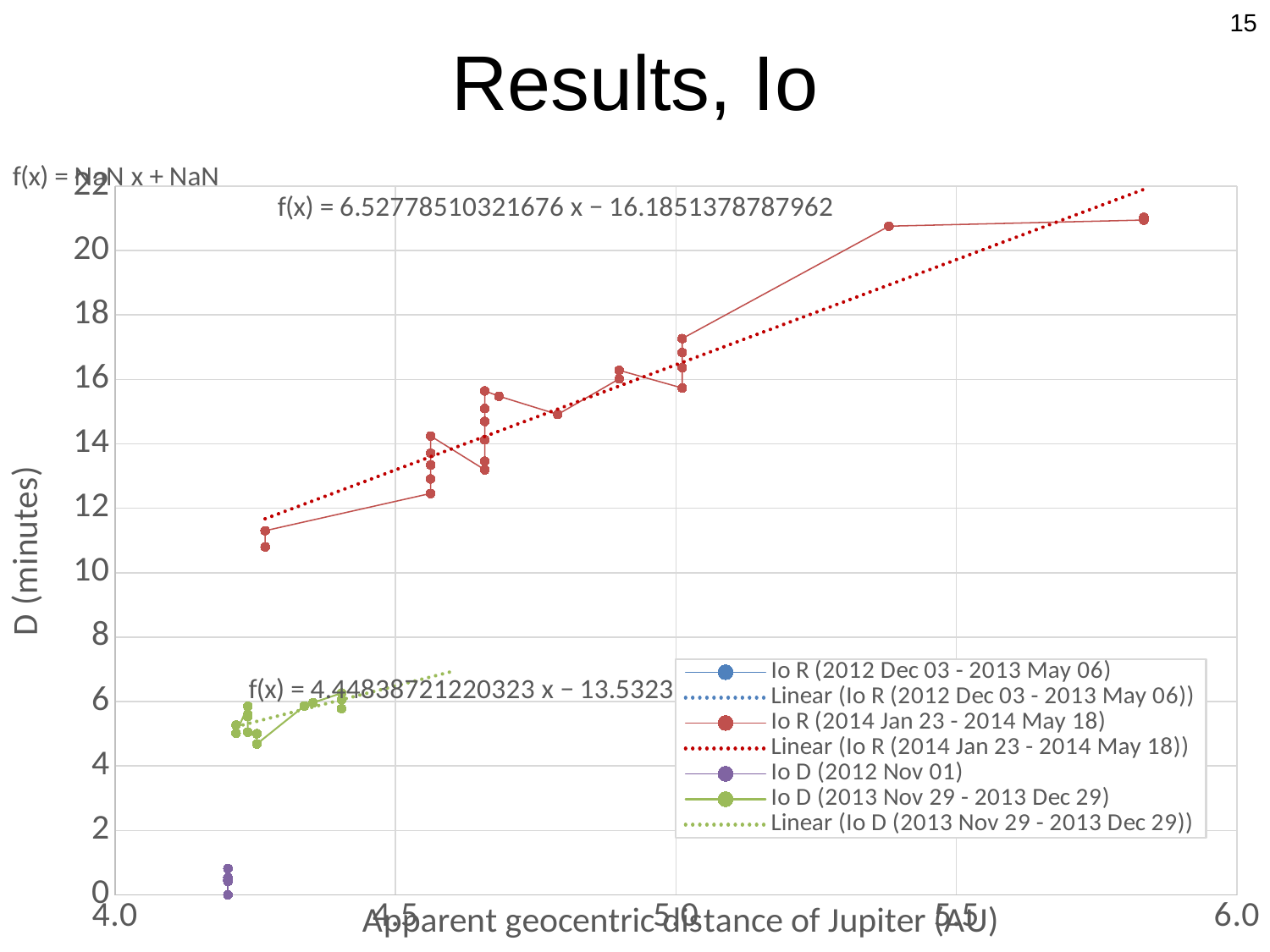
What is the slope shown in the trendline equation for the Io R (2014 Jan 23 - 2014 May 18) series? 6.52778510321676 Do the values of the Io R (2014 Jan 23 - 2014 May 18) series rise or fall as the apparent geocentric distance increases? rise Are the values of the Io D (2013 Nov 29 - 2013 Dec 29) series greater or less than 8? less Are the values of the Io D (2012 Nov 01) series greater or less than 2? less Is the highest value of the Io R (2014 Jan 23 - 2014 May 18) series greater or less than 20? greater What is the title of the chart? Results, Io How many entries does the chart's legend list? 7 Which series has the higher values, Io R (2014 Jan 23 - 2014 May 18) or Io D (2013 Nov 29 - 2013 Dec 29)? Io R (2014 Jan 23 - 2014 May 18) What kind of chart is shown on the slide? scatter chart What is the label of the y axis? D (minutes) Which series has the lowest values on the chart? Io D (2012 Nov 01)